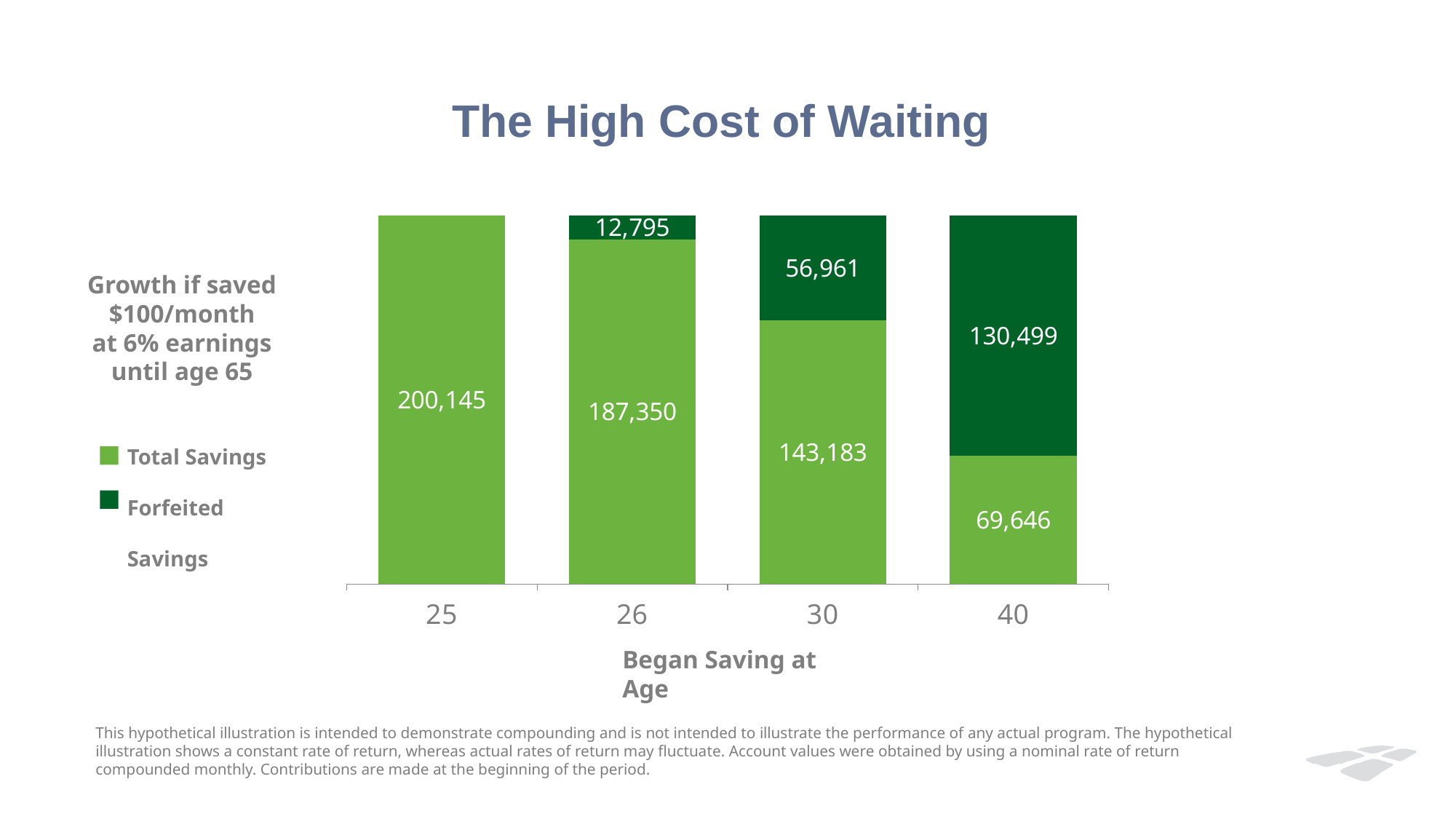
What is the Total Savings value for someone who began saving at age 25? 200,145 Which starting age has the highest Forfeited Savings? 40 Which starting age has the lowest Total Savings? 40 How many starting ages are shown on the x axis? 4 What type of chart is shown on the slide? Stacked bar chart What is the difference in Forfeited Savings between starting at age 40 and starting at age 30? 73,538 Which is larger: Total Savings at age 30 or Forfeited Savings at age 40? Total Savings at age 30 What is the Forfeited Savings value for someone who began saving at age 26? 12,795 What is the combined total of Total Savings and Forfeited Savings for the age 40 bar? 200,145 What is the difference in Total Savings between starting at age 25 and starting at age 26? 12,795 What is the Total Savings value for someone who began saving at age 40? 69,646 What is the Forfeited Savings value for someone who began saving at age 30? 56,961